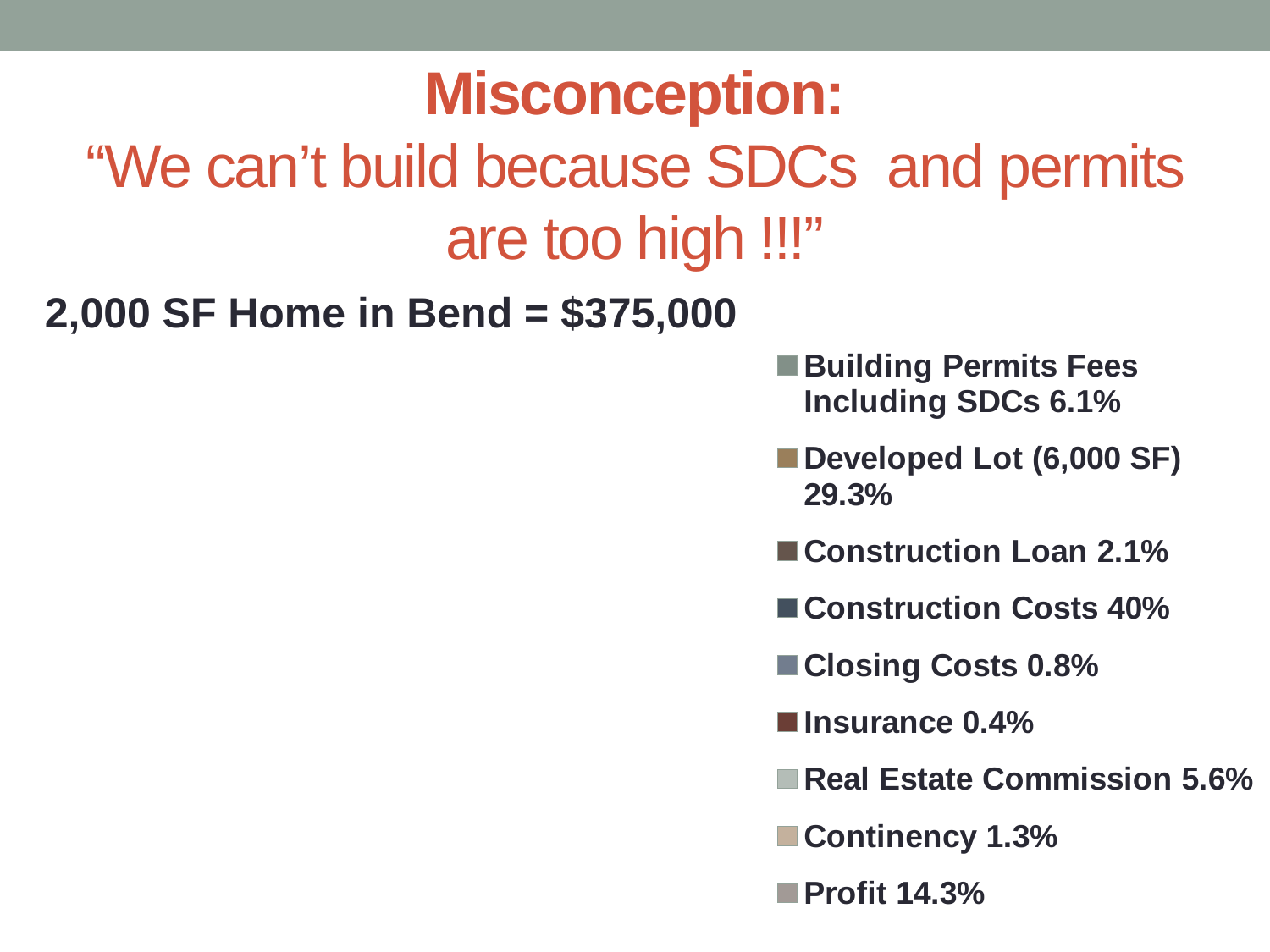
What is the difference in percentage points between Construction Costs and Developed Lot (6,000 SF)? 10.7 According to the legend, what percentage is attributed to Developed Lot (6,000 SF)? 29.3% According to the legend, what percentage is attributed to Construction Costs? 40% According to the legend, what percentage is attributed to Real Estate Commission? 5.6% Which legend category has the highest percentage? Construction Costs Which is larger: the percentage for Profit or the percentage for Building Permits Fees Including SDCs? Profit Which legend category has the lowest percentage? Insurance What is the difference in percentage points between Construction Loan and Closing Costs? 1.3 How many categories does the legend list? 9 According to the legend, what percentage is attributed to Profit? 14.3% According to the legend, what percentage is attributed to Building Permits Fees Including SDCs? 6.1% What total home price is stated on the slide for a 2,000 SF home in Bend? $375,000